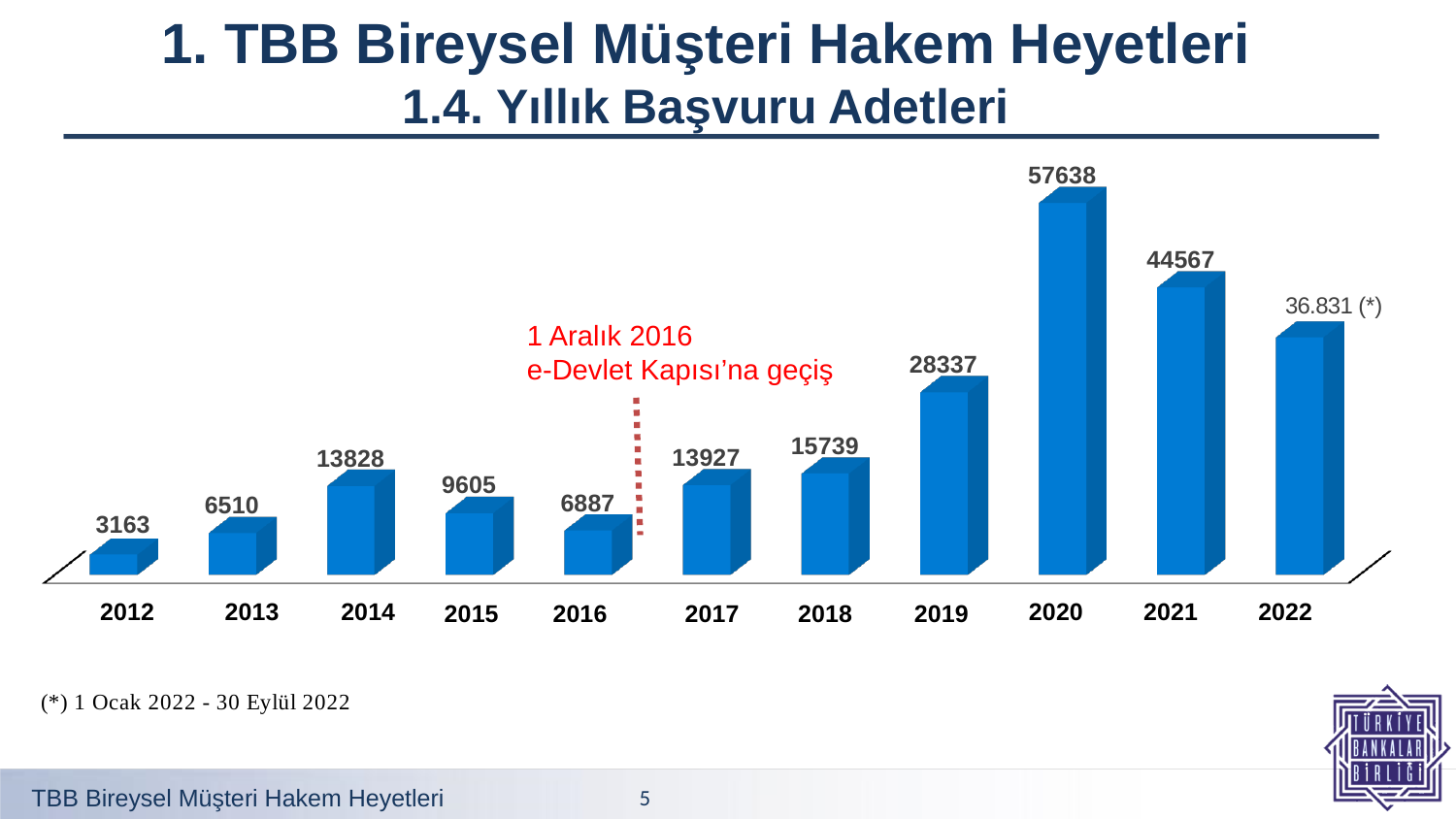
What is the value for 2020? 57638 Which year has the lowest value? 2012 Which year has the highest value? 2020 What is the value for 2019? 28337 What is the value shown for 2022? 36.831 (*) What is the difference between the values for 2014 and 2015? 4223 What kind of chart is shown on the slide? bar chart How many years are shown on the x axis? 11 What is the difference between the values for 2020 and 2021? 13071 Which is larger, the value for 2017 or the value for 2018? 2018 What event does the red annotation on the chart mark? 1 Aralık 2016 e-Devlet Kapısı'na geçiş What is the value for 2012? 3163